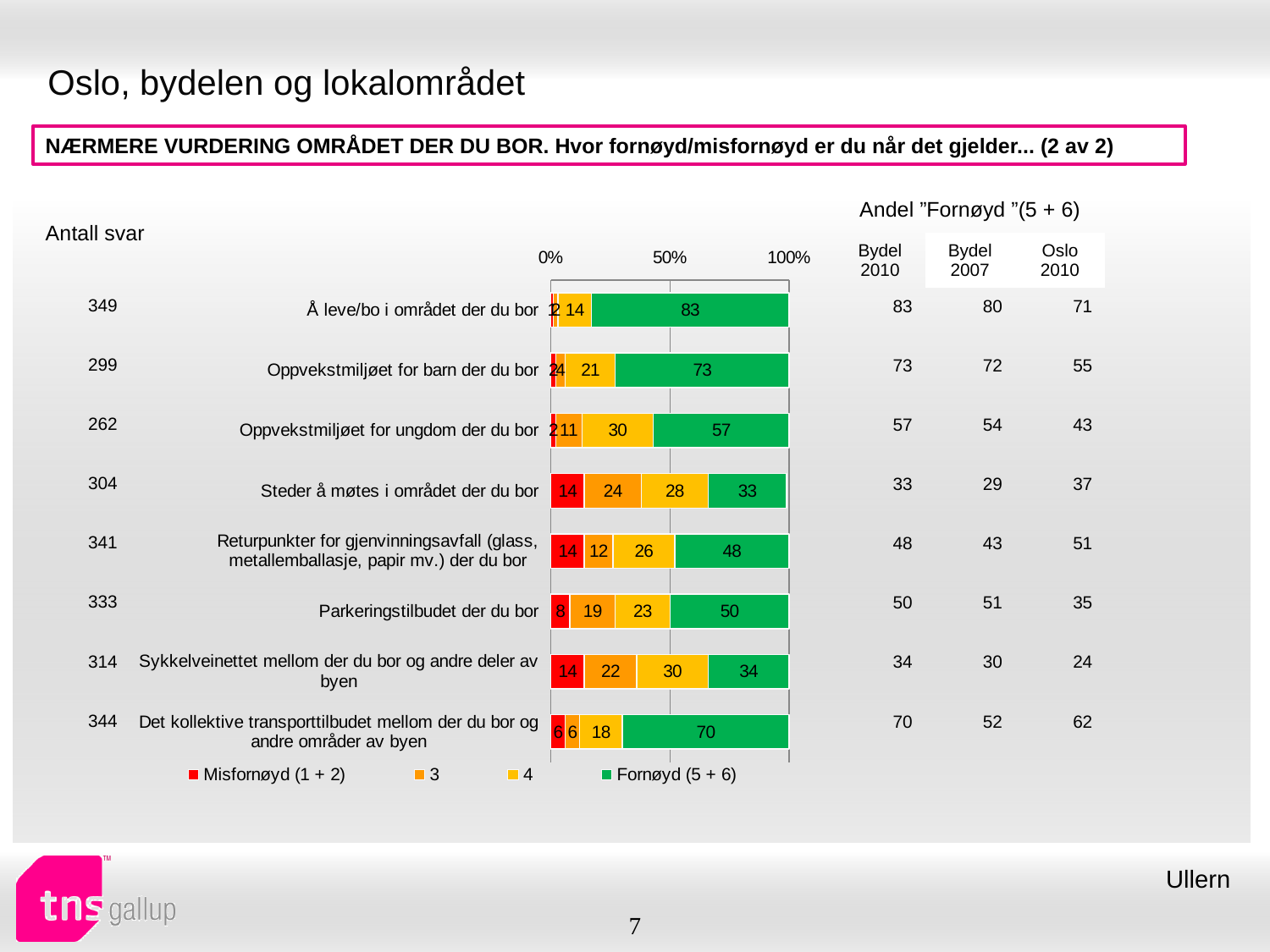
What is the value of series '4' for 'Sykkelveinettet mellom der du bor og andre deler av byen'? 30 What is the Fornøyd (5 + 6) value for 'Parkeringstilbudet der du bor'? 50 What is the difference between the Fornøyd (5 + 6) values for 'Oppvekstmiljøet for barn der du bor' and 'Oppvekstmiljøet for ungdom der du bor'? 16 How many series does the chart legend list? 4 What is the Misfornøyd (1 + 2) value for 'Det kollektive transporttilbudet mellom der du bor og andre områder av byen'? 6 Which category has the highest Fornøyd (5 + 6) value? Å leve/bo i området der du bor What is the total of the stacked bar for 'Parkeringstilbudet der du bor'? 100 Which category has the lowest Fornøyd (5 + 6) value? Steder å møtes i området der du bor What kind of chart is shown on the slide? Stacked bar chart How many categories (rows) are plotted in the chart? 8 What are the four legend entries of the chart? Misfornøyd (1 + 2), 3, 4, Fornøyd (5 + 6) Which has the larger Misfornøyd (1 + 2) value: 'Steder å møtes i området der du bor' or 'Parkeringstilbudet der du bor'? Steder å møtes i området der du bor